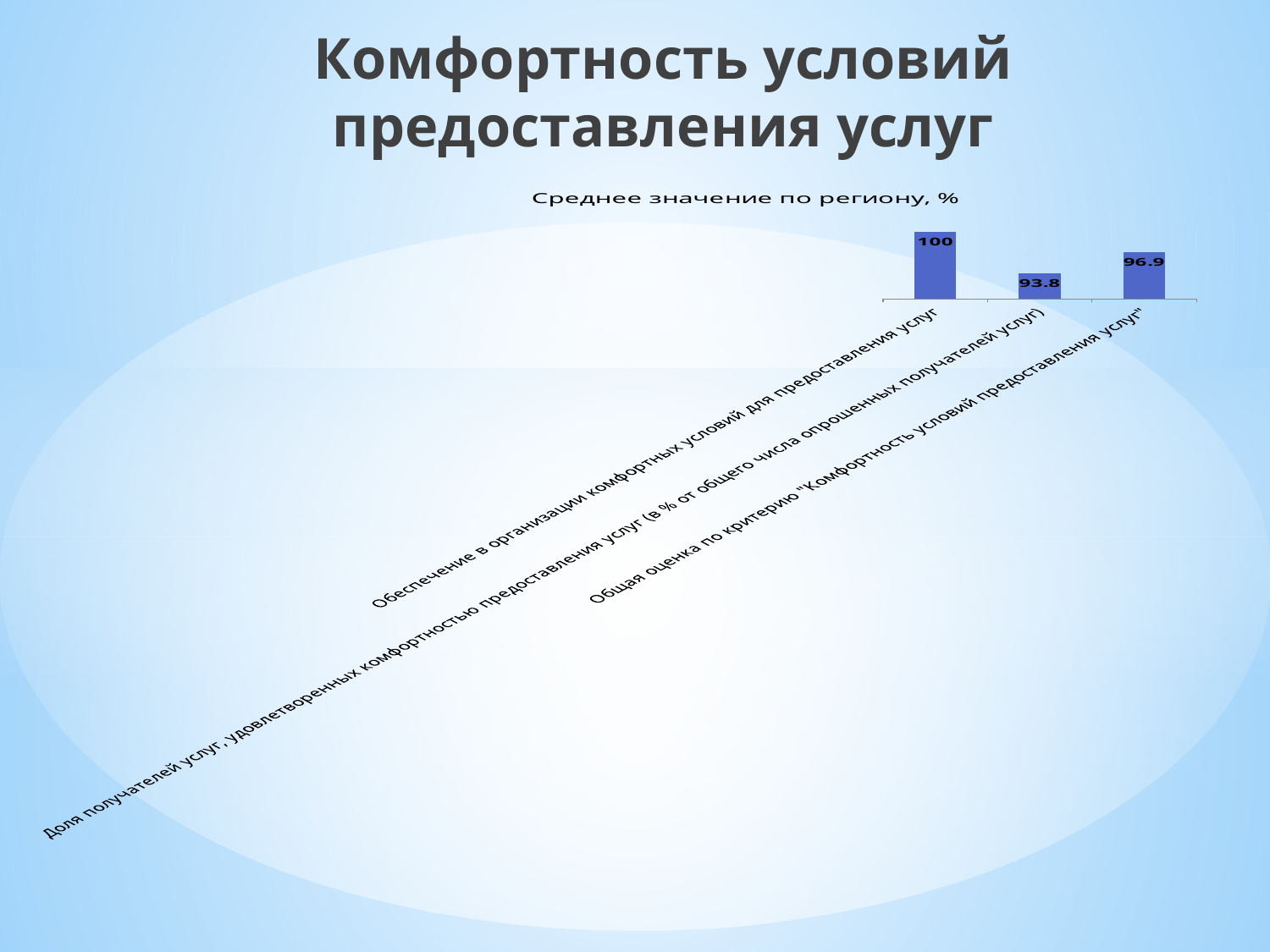
What is the value for "Доля получателей услуг, удовлетворенных комфортностью предоставления услуг"? 93.8 What is the value for "Обеспечение в организации комфортных условий для предоставления услуг"? 100 What is the difference between the value for "Обеспечение в организации комфортных условий для предоставления услуг" and the value for "Доля получателей услуг, удовлетворенных комфортностью предоставления услуг"? 6.2 What kind of chart is shown on the slide? Bar chart How many categories are shown in the chart? 3 Which category has the lowest value? Доля получателей услуг, удовлетворенных комфортностью предоставления услуг What is the difference between the value for "Общая оценка по критерию "Комфортность условий предоставления услуг"" and the value for "Доля получателей услуг, удовлетворенных комфортностью предоставления услуг"? 3.1 What is the title of the chart? Среднее значение по региону, % What is the value for "Общая оценка по критерию "Комфортность условий предоставления услуг""? 96.9 What colour are the bars in the chart? Blue Which is larger: the value for "Общая оценка по критерию "Комфортность условий предоставления услуг"" or the value for "Доля получателей услуг, удовлетворенных комфортностью предоставления услуг"? Общая оценка по критерию "Комфортность условий предоставления услуг" Which category has the highest value? Обеспечение в организации комфортных условий для предоставления услуг